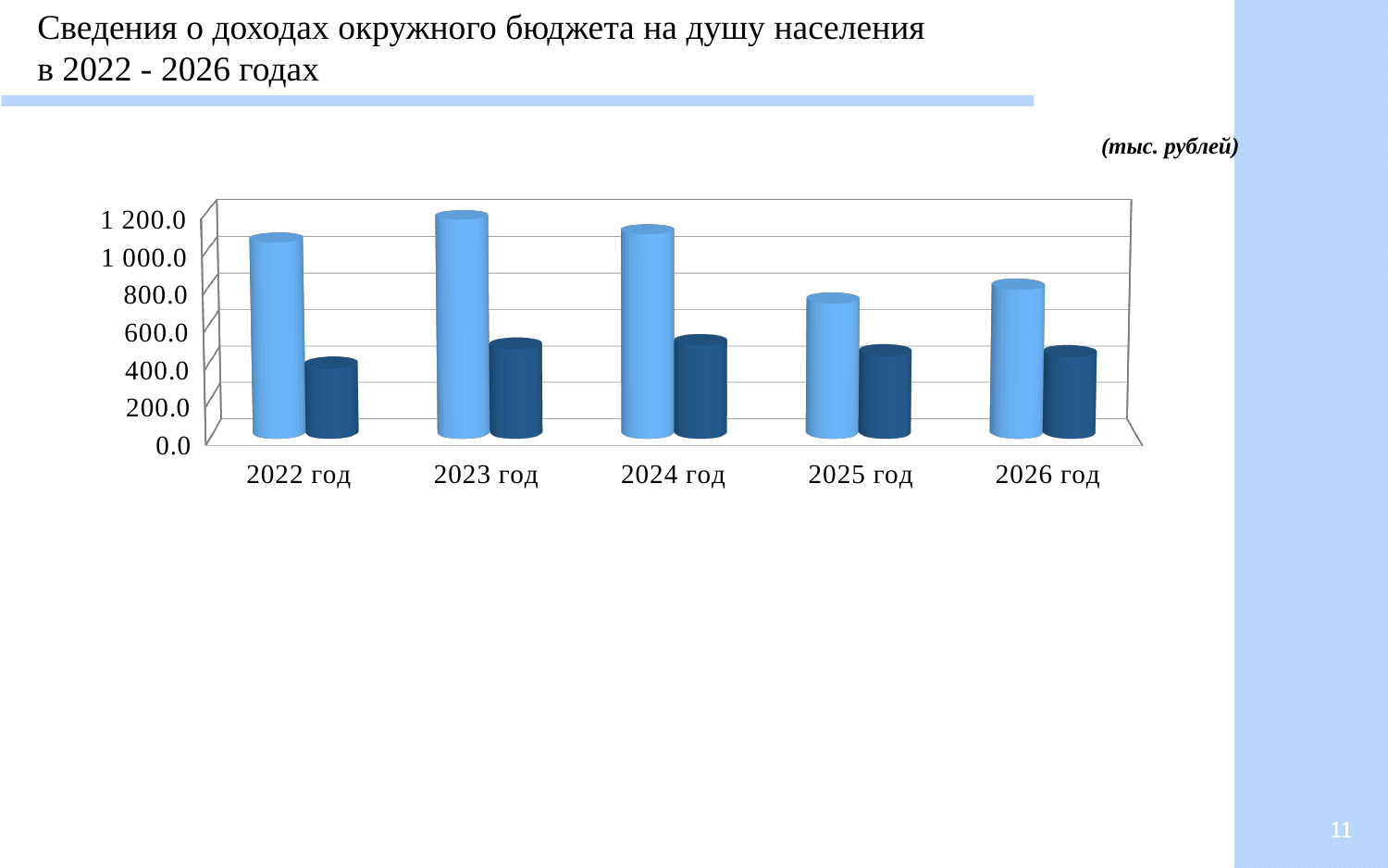
What kind of chart is shown on the slide? Bar chart Is the light blue value for 2023 год greater or less than 1 000.0? greater What unit is indicated for the values in the chart? тыс. рублей How many years (categories) are shown on the x axis of the chart? 5 In which year is the light blue bar the highest? 2023 год Do the light blue values rise or fall from 2023 год to 2025 год? fall Is the light blue value for 2025 год greater or less than 800.0? less How many bars are plotted for each year in the chart? 2 Is the dark blue value for 2022 год greater or less than 600.0? less In which year is the dark blue bar the lowest? 2022 год In which year is the light blue bar the lowest? 2025 год Which is larger: the light blue bar for 2023 год or the light blue bar for 2025 год? 2023 год